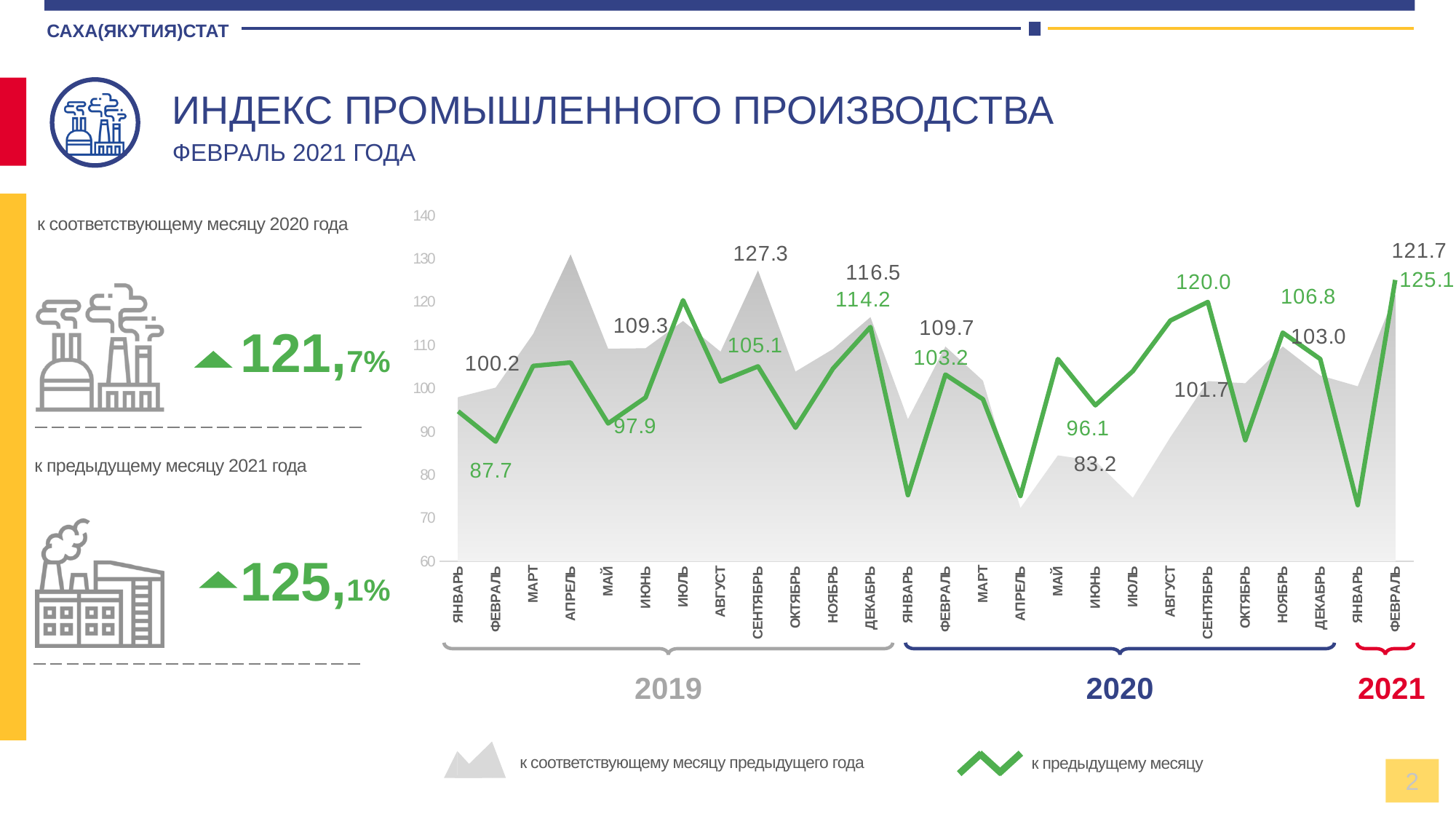
For December 2019, which is larger: the grey area value or the green line value? The grey area value (116.5) What is the value of the grey area series for June 2020? 83.2 Is the green line value for January 2021 greater or less than 80? less What is the value of the grey area series for September 2019? 127.3 How many monthly points are plotted along the x axis of the chart? 26 How many series does the chart legend list? 2 What is the value of the green line (к предыдущему месяцу) for February 2021? 125.1 In which month does the grey area series reach its highest value? April 2019 What is the difference between the green line value and the grey area value for February 2021? 3.4 What is the value of the grey area series (к соответствующему месяцу предыдущего года) for February 2021? 121.7 Which years are marked by the brackets under the x axis of the chart? 2019, 2020 and 2021 What kind of chart is shown on the slide? A line chart with a shaded area series